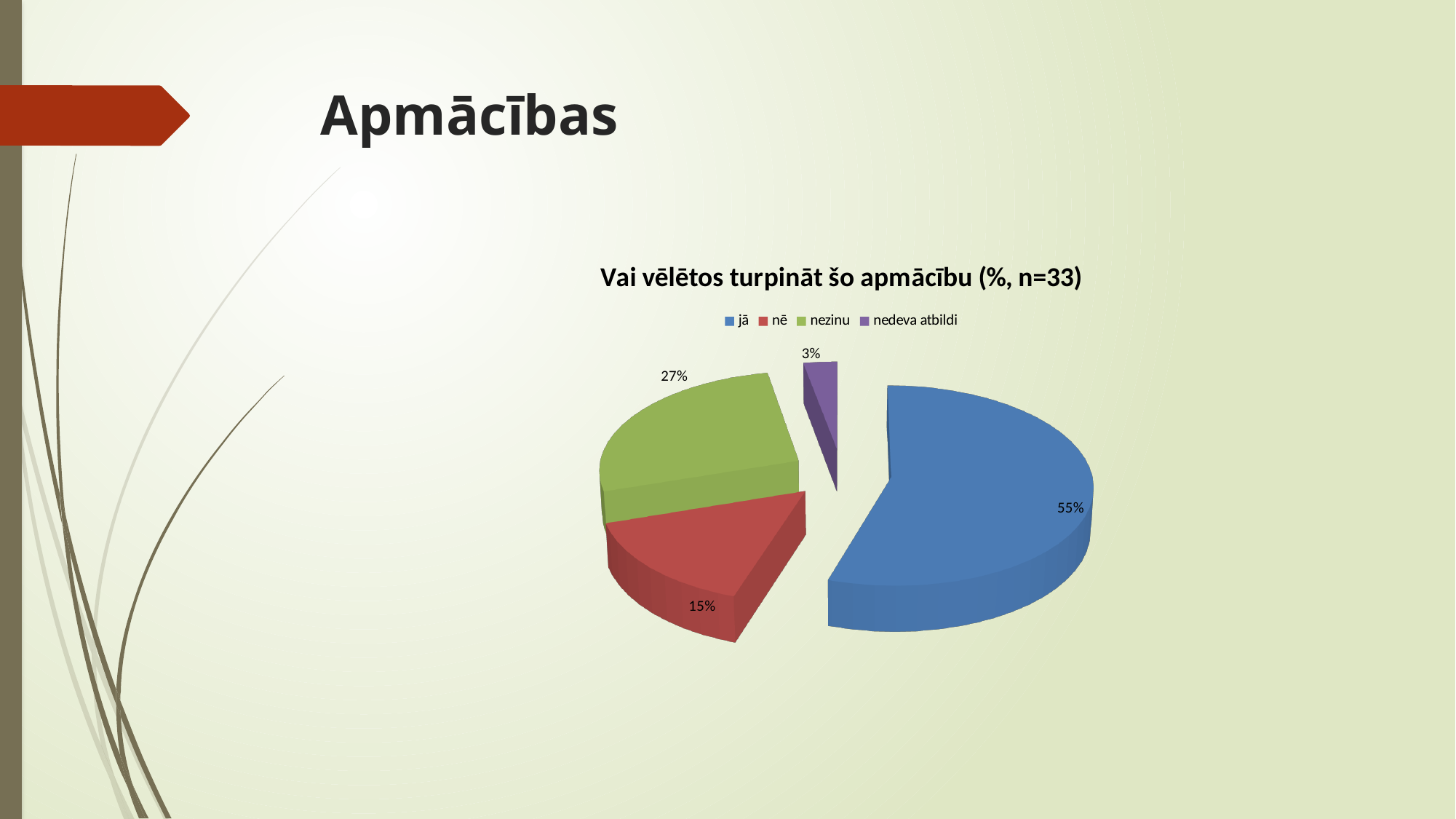
What share of the pie does "jā" have? 55% What is the value for "nē"? 15% What is the difference between the values for "nezinu" and "nē"? 12% Which category has the largest slice? jā What kind of chart is shown on the slide? pie chart What is the value for "nedeva atbildi"? 3% What is the value for "nezinu"? 27% How many categories does the pie chart show? 4 Which is larger, the value for "nē" or the value for "nezinu"? nezinu What is the title of the chart? Vai vēlētos turpināt šo apmācību (%, n=33) What is the difference between the values for "jā" and "nezinu"? 28% Which category has the smallest slice? nedeva atbildi